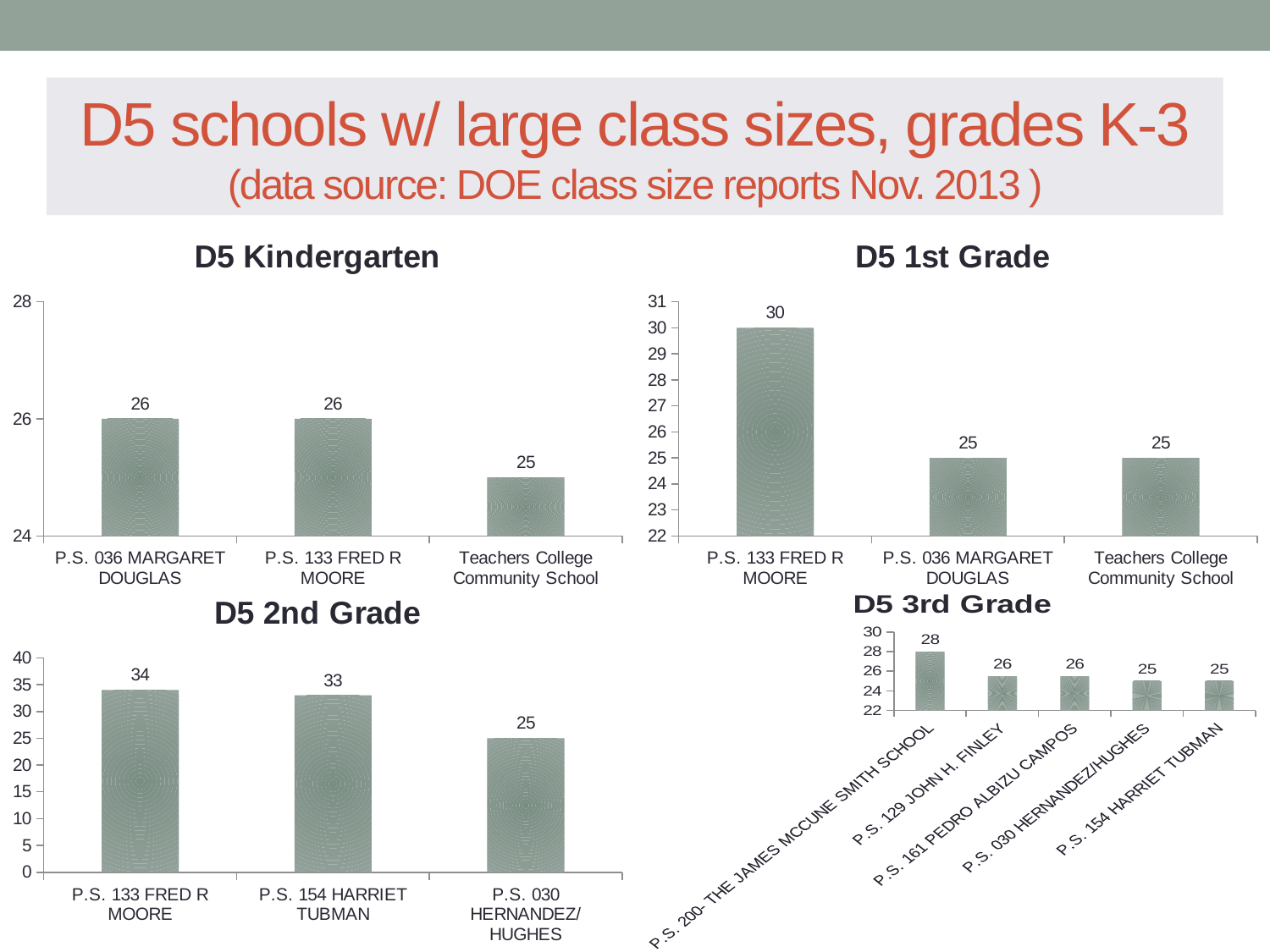
In the D5 1st Grade chart, what is the value for P.S. 133 FRED R MOORE? 30 In the D5 3rd Grade chart, what is the value for P.S. 161 PEDRO ALBIZU CAMPOS? 26 In the D5 3rd Grade chart, which school has the highest value? P.S. 200- THE JAMES MCCUNE SMITH SCHOOL How many schools are shown in the D5 Kindergarten chart? 3 In the D5 Kindergarten chart, what is the value for Teachers College Community School? 25 In the D5 2nd Grade chart, which school has the lowest value? P.S. 030 HERNANDEZ/HUGHES In the D5 3rd Grade chart, which is larger: the value for P.S. 129 JOHN H. FINLEY or the value for P.S. 154 HARRIET TUBMAN? P.S. 129 JOHN H. FINLEY In the D5 2nd Grade chart, what is the difference between P.S. 133 FRED R MOORE and P.S. 154 HARRIET TUBMAN? 1 How many schools are shown in the D5 3rd Grade chart? 5 In the D5 2nd Grade chart, which school has the highest value? P.S. 133 FRED R MOORE In the D5 1st Grade chart, what is the difference between P.S. 133 FRED R MOORE and Teachers College Community School? 5 What kind of chart is the D5 2nd Grade chart? bar chart